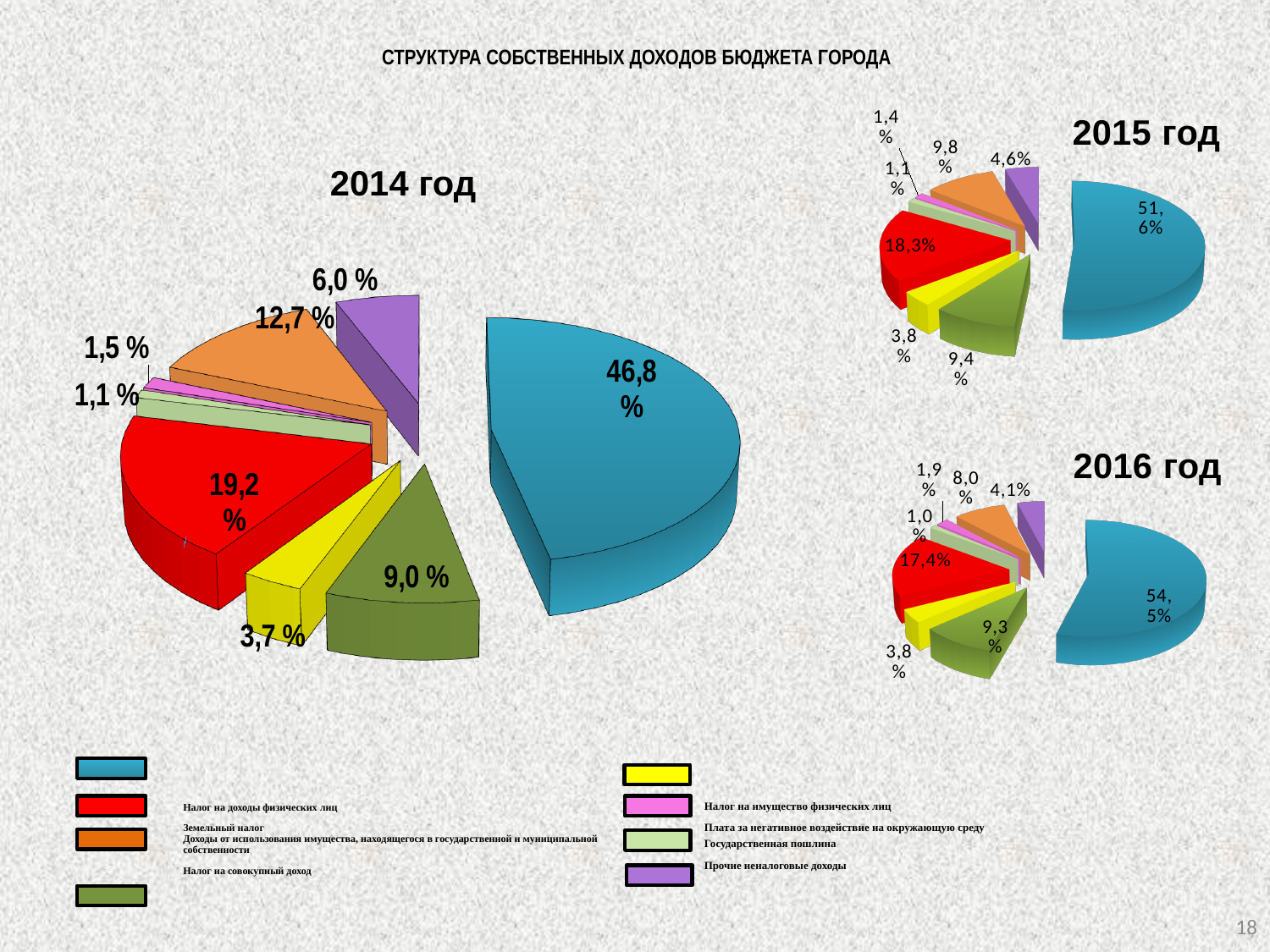
In the 2015 год chart, what is the value of the largest (blue) slice? 51,6% In the 2015 год chart, what is the value of the orange slice? 9,8% Does the share of the blue slice rise or fall from 2014 to 2016 across the three charts? rise In the 2014 год chart, what is the smallest slice value shown? 1,1 % In the 2016 год chart, what is the value of the largest (blue) slice? 54,5% What is the difference between the blue slice in the 2016 год chart (54,5%) and the blue slice in the 2014 год chart (46,8 %)? 7,7 percentage points In the 2014 год chart, what is the value of the largest (blue) slice? 46,8 % How many slices does the 2016 год pie chart have? 8 In the 2016 год chart, what is the value of the red slice? 17,4% Which is larger: the red slice in the 2014 год chart or the red slice in the 2015 год chart? 2014 год (19,2 %) In the 2014 год chart, what is the value of the red slice? 19,2 % What kind of chart is used for the 2014 год chart? pie chart